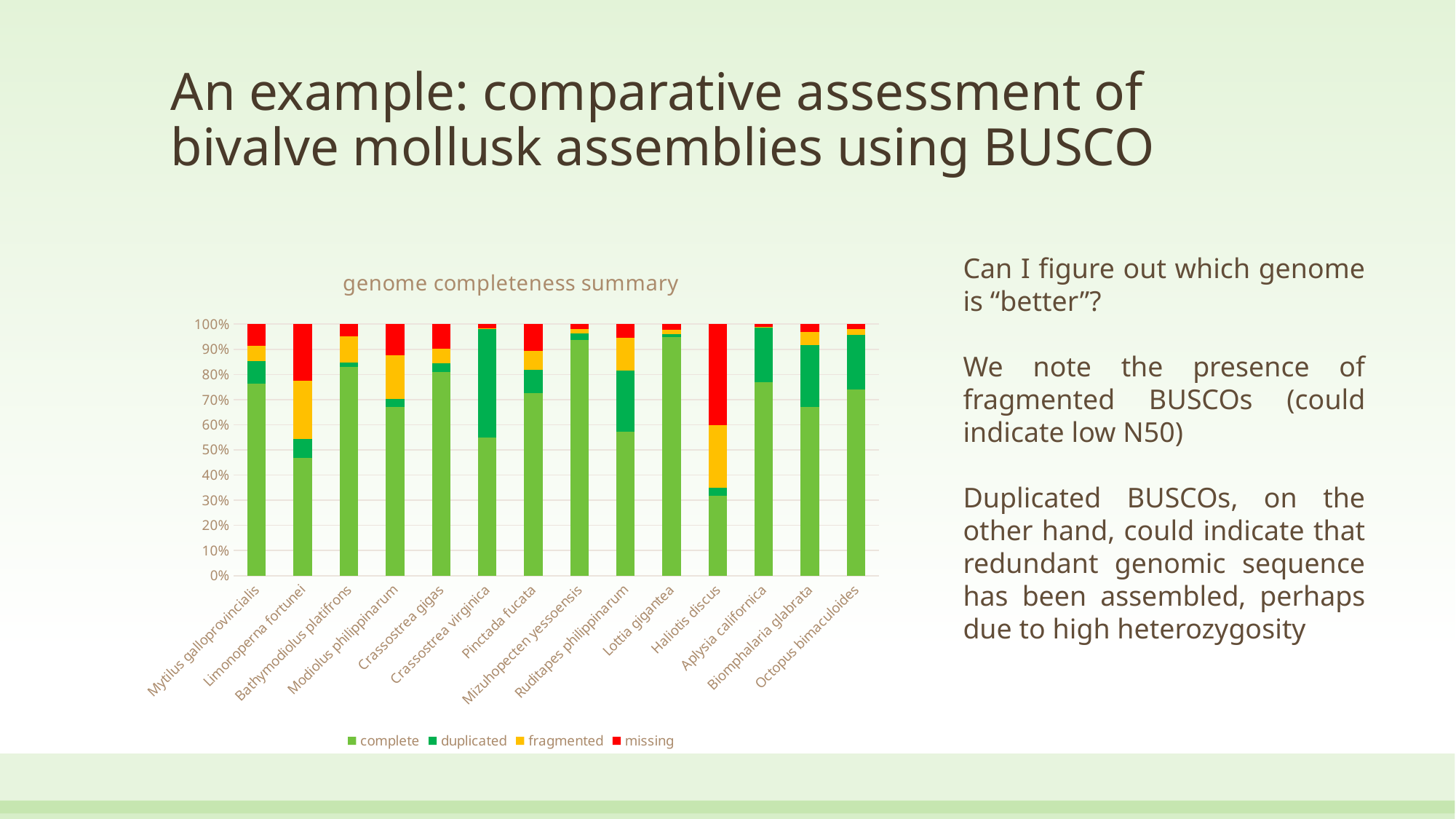
How many series does the chart legend list? 4 Which has the larger 'complete' share, Mytilus galloprovincialis or Limonoperna fortunei? Mytilus galloprovincialis What kind of chart is shown on the slide? stacked bar chart Which species has the largest 'missing' share? Haliotis discus Is the 'complete' value for Haliotis discus greater or less than 40%? less What is the title of the chart? genome completeness summary How many species (categories) are plotted along the x axis? 14 Is the 'complete' value for Mytilus galloprovincialis greater or less than 70%? greater Which species has the lowest 'complete' share? Haliotis discus Is the 'complete' value for Crassostrea virginica greater or less than 50%? greater What is the total height of each stacked bar on the y axis? 100% Which series is shown in red in the chart? missing